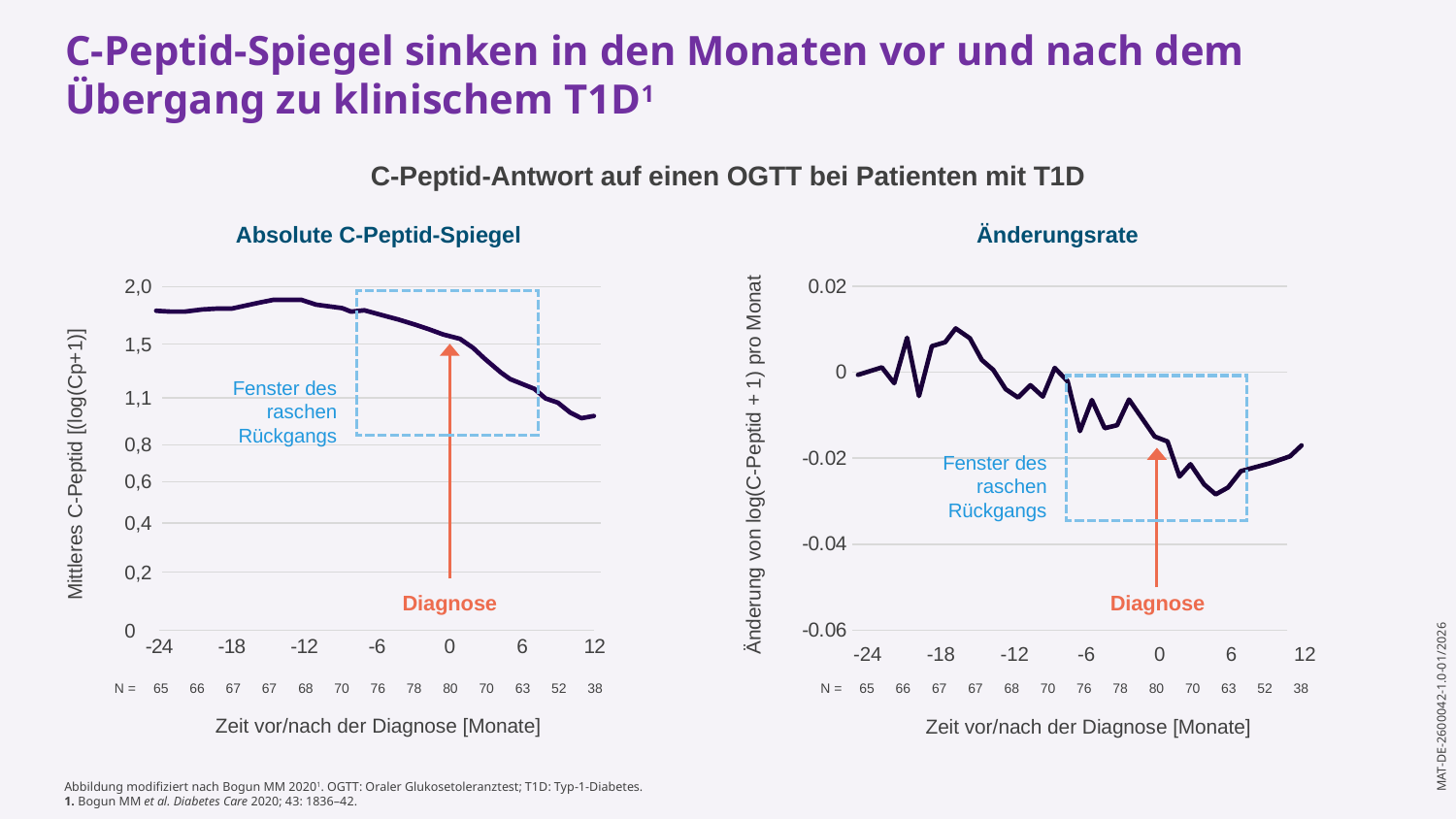
In the left chart (Absolute C-Peptid-Spiegel), do the values rise or fall overall from -24 to 12 months? fall In the left chart (Absolute C-Peptid-Spiegel), what is the N value shown at 0 months (diagnosis)? 80 In the left chart (Absolute C-Peptid-Spiegel), is the value at -24 months greater or less than 1.5? greater How many N values are listed below the x axis of the right chart (Änderungsrate)? 13 In the right chart (Änderungsrate), what is the N value shown at 12 months? 38 In the right chart (Änderungsrate), is the value at -18 months greater or less than 0? greater In the left chart (Absolute C-Peptid-Spiegel), what is the difference between the N value at 0 months (80) and at 12 months (38)? 42 In the left chart (Absolute C-Peptid-Spiegel), at which time point is the N value highest? 0 In the left chart (Absolute C-Peptid-Spiegel), is the value at 12 months greater or less than 1.5? less What kind of chart is the left chart titled "Absolute C-Peptid-Spiegel"? line chart